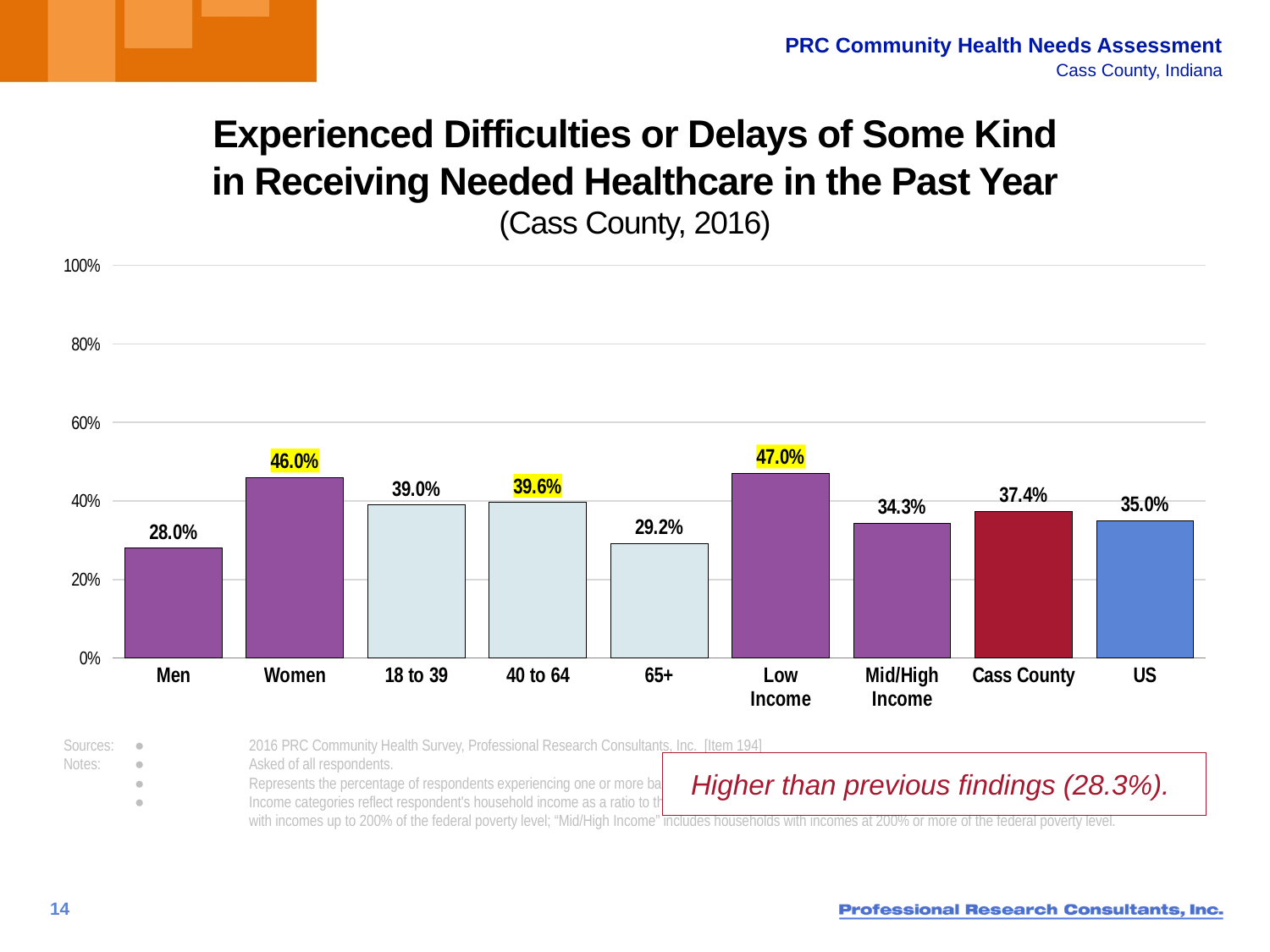
What is the difference between the values for Women and Men? 18.0% Which is larger, the value for Low Income or the value for Mid/High Income? Low Income Which category has the lowest value? Men What is the value for 65+? 29.2% What is the value for Women? 46.0% What is the value for Cass County? 37.4% How many categories are shown on the x axis? 9 Which category has the highest value? Low Income What is the value for Low Income? 47.0% What is the difference between the values for Cass County and US? 2.4% What kind of chart is shown on the slide? bar chart Is the value for 18 to 39 greater or less than 40%? less